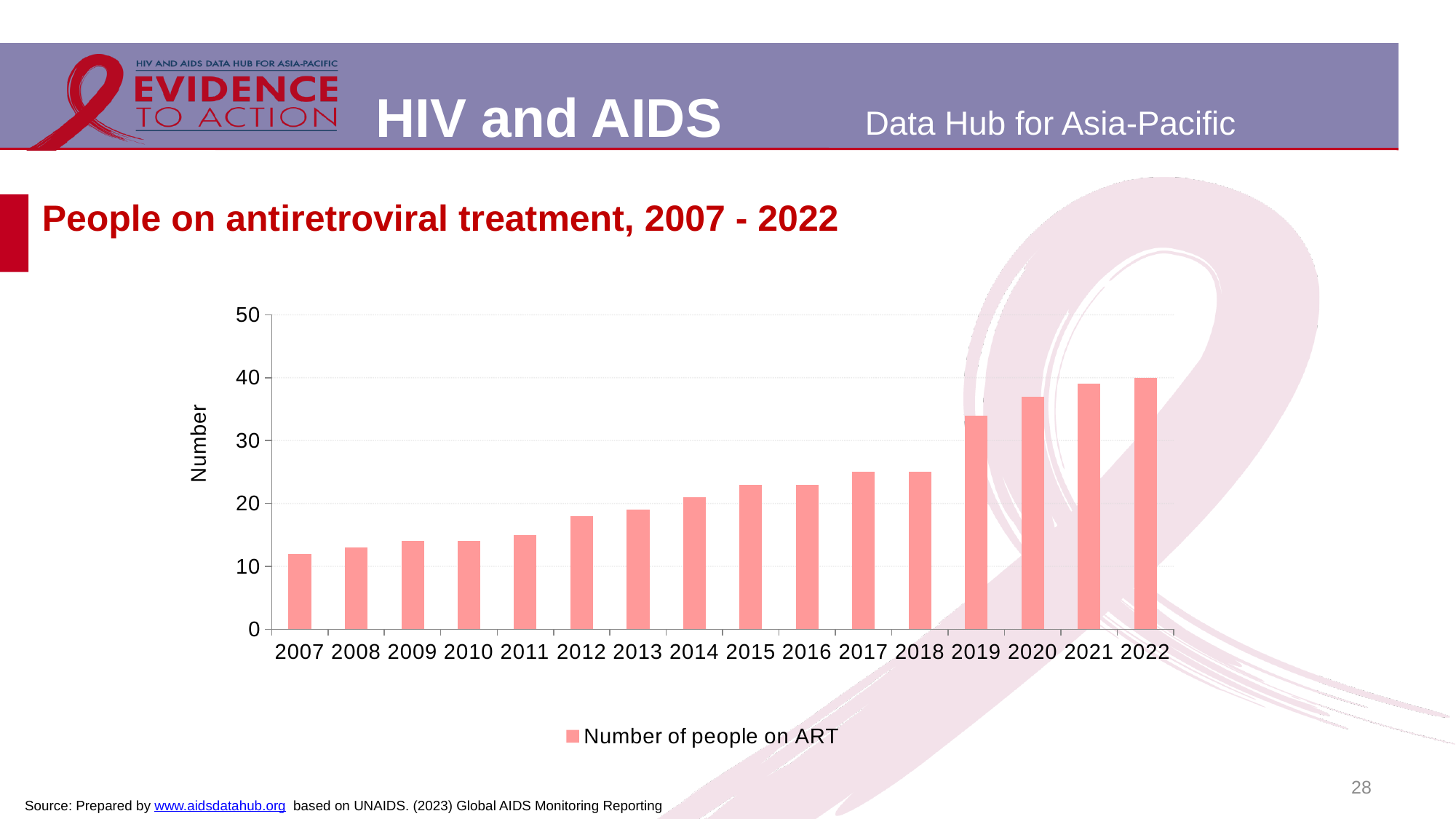
Which year has the lowest number of people on ART? 2007 Is the value for 2007 greater or less than 20? less What kind of chart is shown on the slide? bar chart Is the value for 2019 greater or less than 30? greater Which year has the larger value, 2012 or 2018? 2018 How many years are shown on the x axis of the chart? 16 What is the name of the series shown in the legend? Number of people on ART What is the title of the chart? People on antiretroviral treatment, 2007 - 2022 How many series does the chart legend list? 1 Do the values generally rise or fall from 2007 to 2022? rise Which year has the highest number of people on ART? 2022